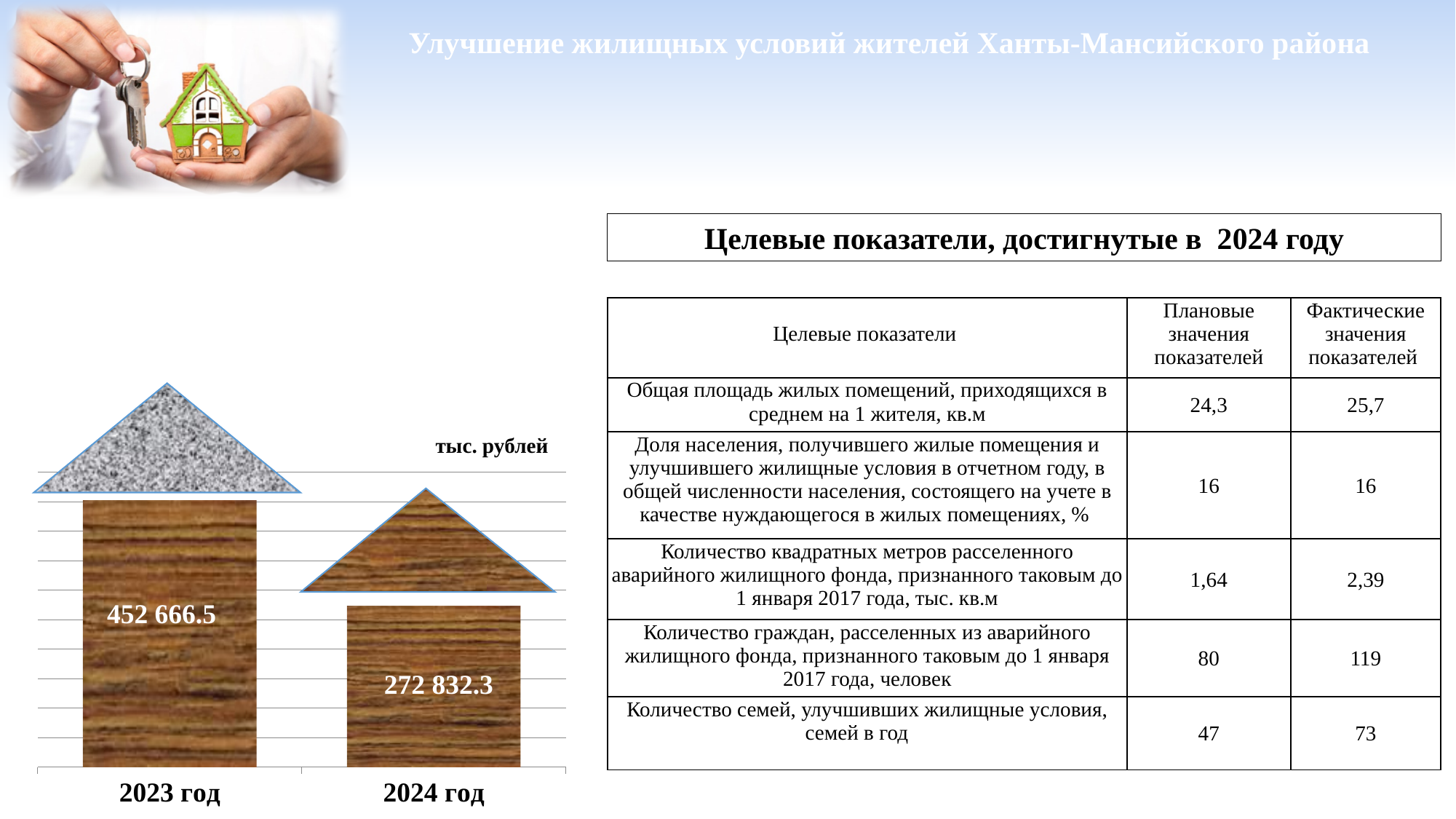
What is the value shown for 2024 год on the bar chart? 272 832.3 Which year has the higher value on the bar chart? 2023 год What is the difference between the 2023 год and 2024 год values on the bar chart? 179 834.2 How many bars (categories) are shown on the bar chart? 2 Is the value for 2023 год larger or smaller than the value for 2024 год on the bar chart? larger What unit is indicated for the values on the bar chart? тыс. рублей Which year has the lower value on the bar chart? 2024 год What shape is placed on top of each bar in the bar chart? a triangular roof What is the value shown for 2023 год on the bar chart? 452 666.5 Do the values on the bar chart rise or fall from 2023 год to 2024 год? fall What kind of chart is shown on the left of the slide? bar chart